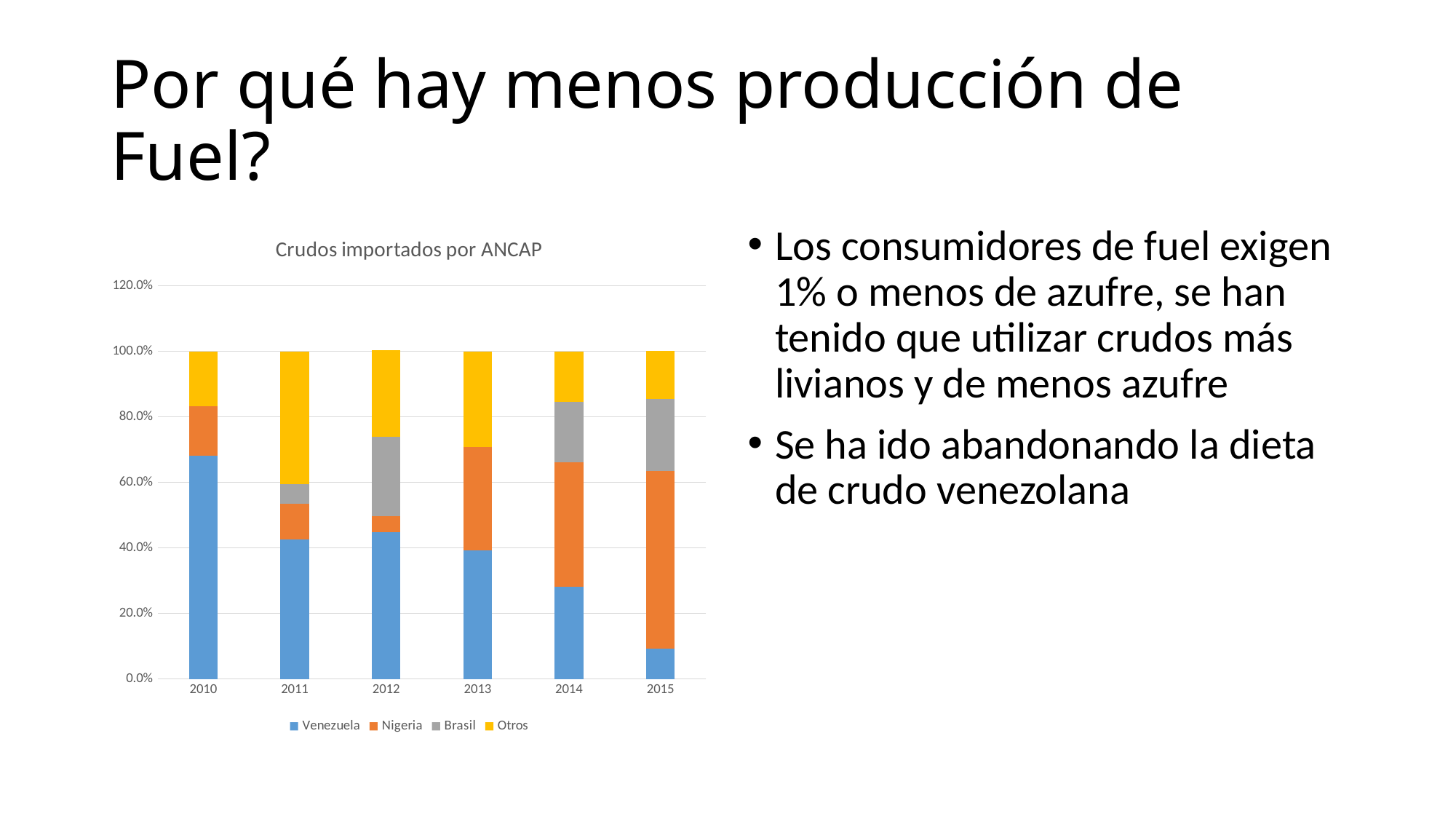
In which year is the Otros share the largest? 2011 How many years are shown on the x axis of the chart? 6 Is the Venezuela share in 2010 greater or less than 60.0%? greater How many series does the chart legend list? 4 Is the Venezuela share in 2015 greater or less than 20.0%? less In which year is the Venezuela share of imported crude the highest? 2010 What kind of chart is shown on the slide? Stacked bar chart In which year is the Venezuela share of imported crude the lowest? 2015 Which series is shown in blue in the chart? Venezuela Which is larger: the Nigeria share in 2015 or the Nigeria share in 2010? 2015 What is the title of the chart? Crudos importados por ANCAP Does the Venezuela share generally rise or fall from 2010 to 2015? Fall